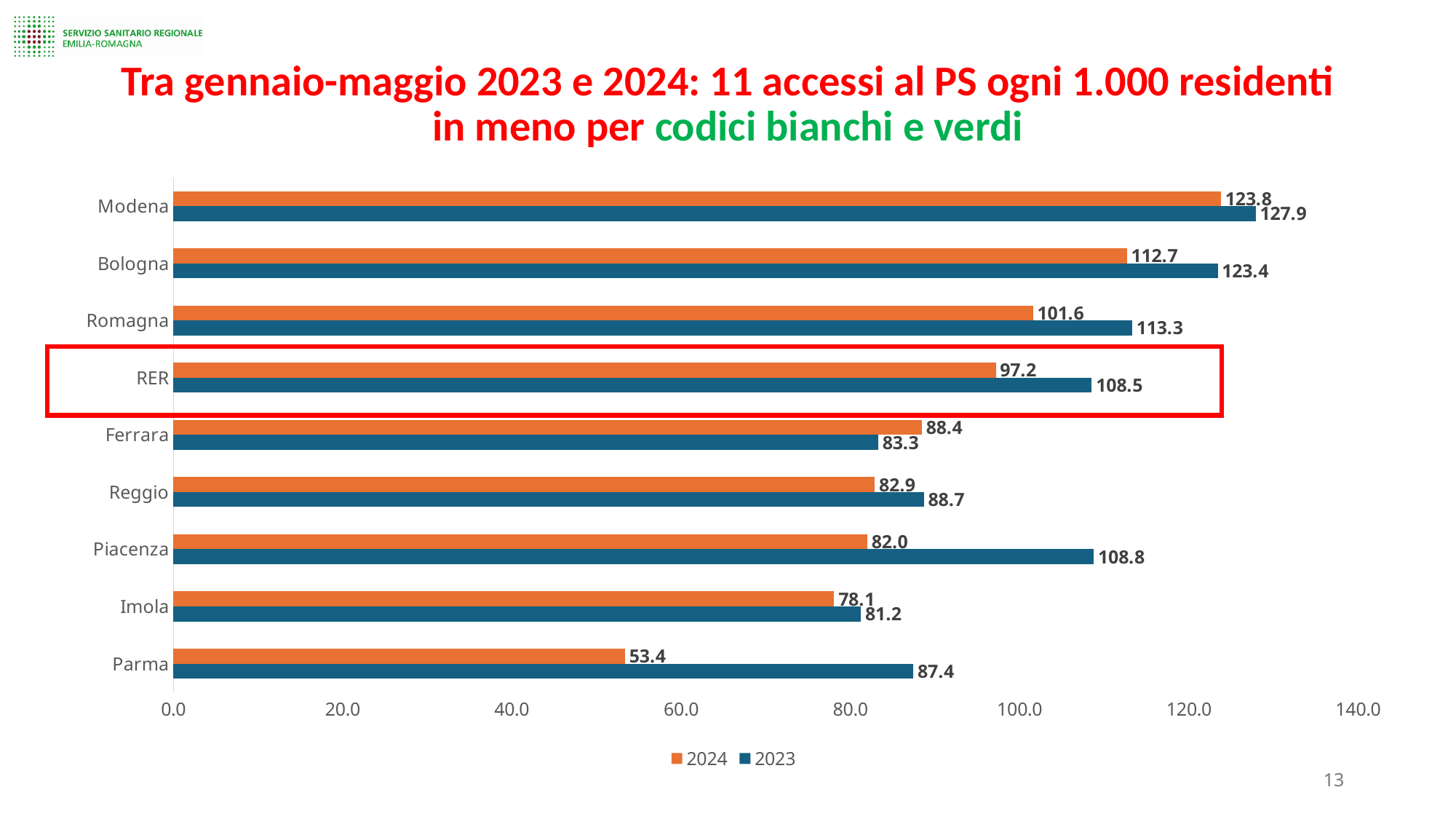
Which is larger for Ferrara, the 2023 value or the 2024 value? 2024 Which category has the lowest 2024 value? Parma What is the 2024 value for RER? 97.2 How many categories are shown on the y axis? 9 What is the difference between the 2023 and 2024 values for RER? 11.3 What is the difference between the 2023 and 2024 values for Parma? 34.0 Which series is shown in orange? 2024 Which category has the highest 2023 value? Modena What is the 2024 value for Modena? 123.8 How many series does the legend list? 2 What kind of chart is shown on the slide? Bar chart What is the 2023 value for Piacenza? 108.8